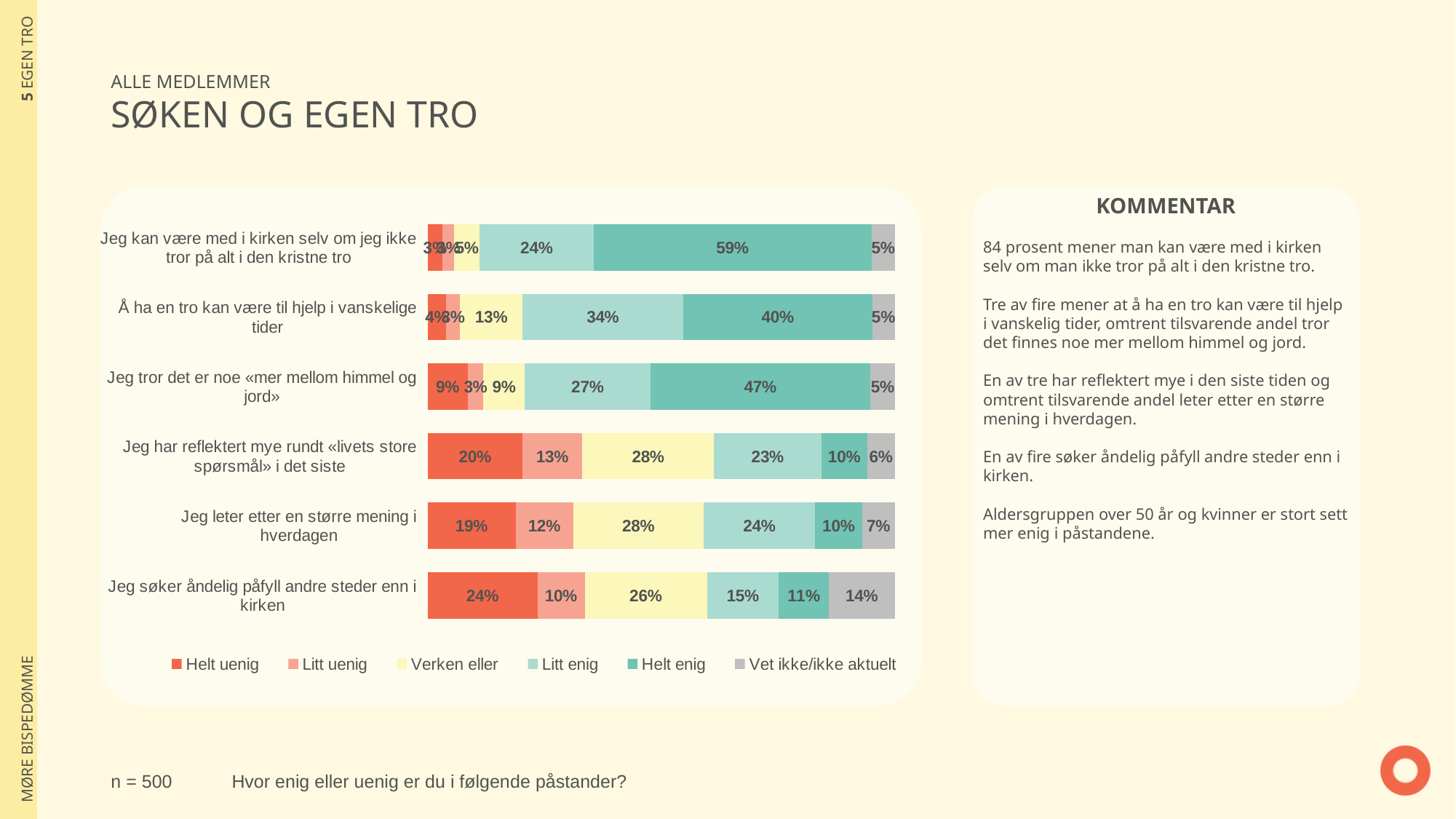
What kind of chart is shown on the slide? Stacked bar chart What is the 'Litt enig' value for 'Å ha en tro kan være til hjelp i vanskelige tider'? 34% What is the 'Helt uenig' value for 'Jeg søker åndelig påfyll andre steder enn i kirken'? 24% What is the difference between the 'Helt enig' values for 'Jeg tror det er noe «mer mellom himmel og jord»' and 'Å ha en tro kan være til hjelp i vanskelige tider'? 7% How many series does the legend list? 6 How many statements (categories) are plotted in the chart? 6 What is the 'Helt enig' value for 'Jeg kan være med i kirken selv om jeg ikke tror på alt i den kristne tro'? 59% What is the 'Vet ikke/ikke aktuelt' value for 'Jeg leter etter en større mening i hverdagen'? 7% What colour represents 'Helt uenig' in the legend? Red Which statement has the highest 'Helt enig' value? Jeg kan være med i kirken selv om jeg ikke tror på alt i den kristne tro Which is larger: the 'Helt uenig' value for 'Jeg har reflektert mye rundt «livets store spørsmål» i det siste' or for 'Jeg leter etter en større mening i hverdagen'? Jeg har reflektert mye rundt «livets store spørsmål» i det siste Which statement has the lowest 'Litt enig' value? Jeg søker åndelig påfyll andre steder enn i kirken